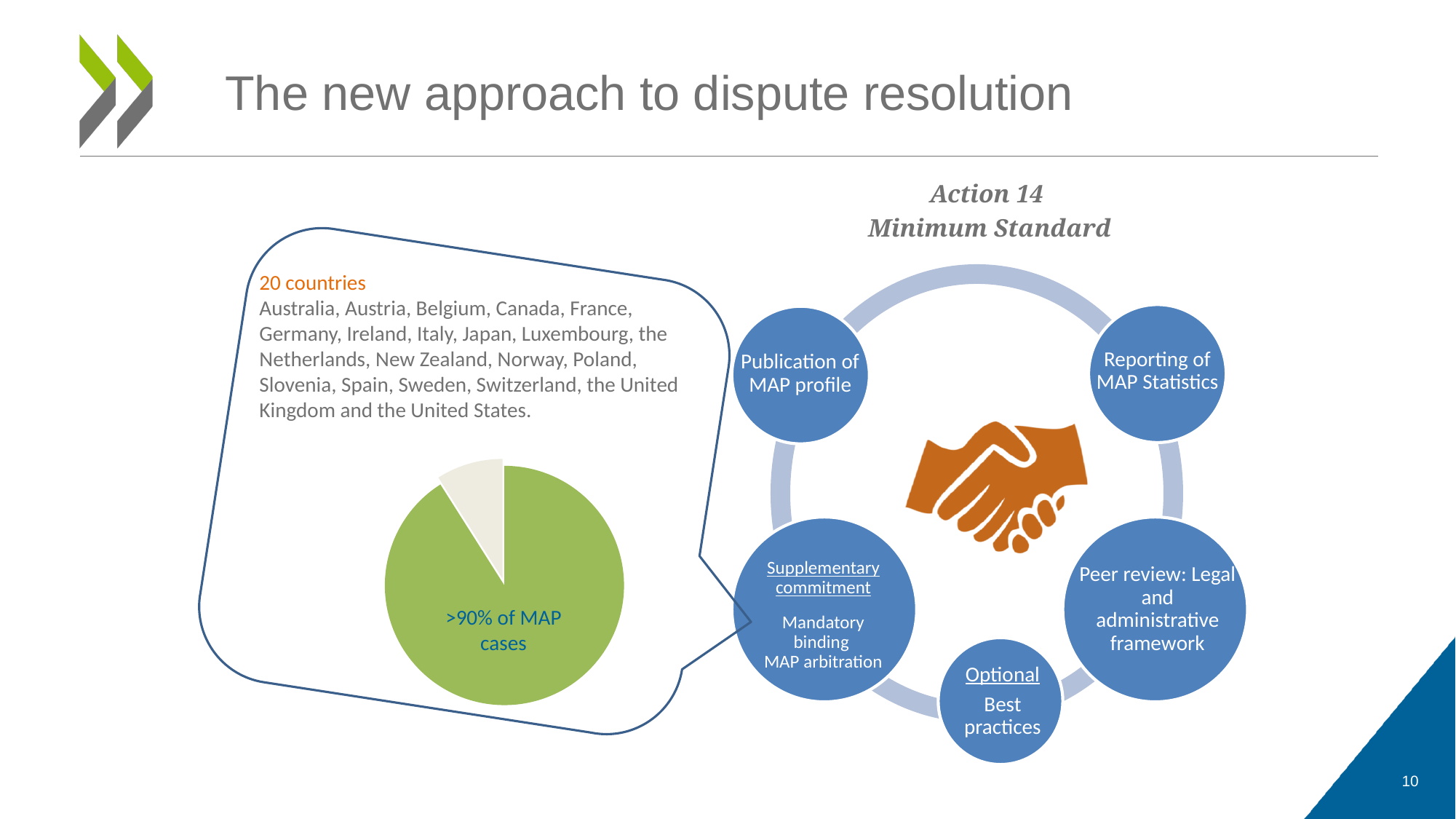
Which slice of the pie chart is the smallest? the beige slice How many slices does the pie chart have? 2 What kind of chart is shown inside the speech bubble on the left of the slide? pie chart What label is printed on the large green slice of the pie chart? >90% of MAP cases Which slice of the pie chart is larger, the green slice or the beige slice? the green slice According to its label, what share of MAP cases does the green slice of the pie chart represent? >90% What colour is the largest slice of the pie chart? green How many countries does the text above the pie chart say are covered? 20 countries